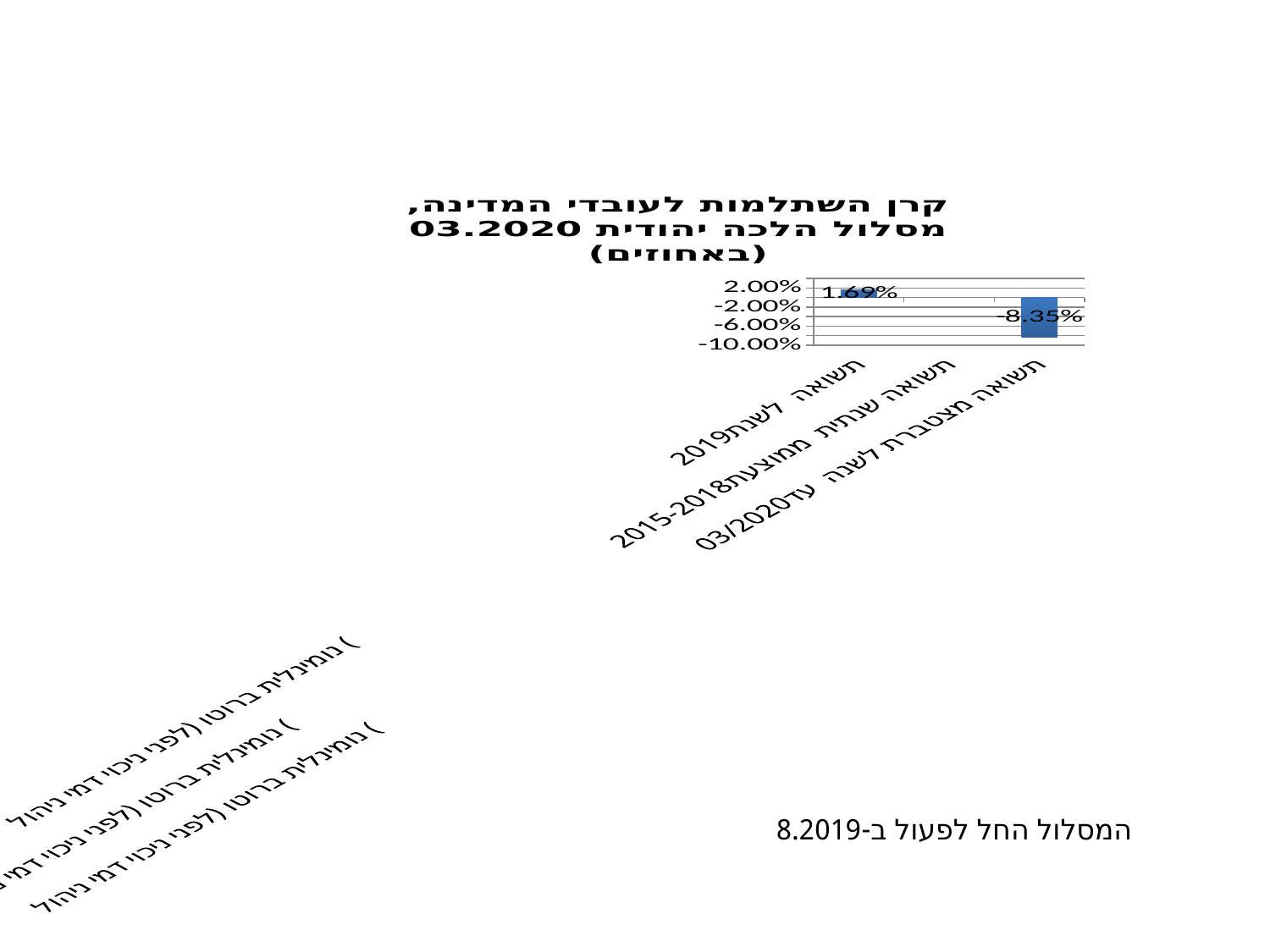
Is the value for תשואה לשנת 2019 greater or less than -2.00%? greater Which category has the lowest value in the chart? תשואה מצטברת לשנה עד 03/2020 What is the value shown for תשואה לשנת 2019? 1.69% How many categories are shown on the x axis of the chart? 3 What is the title of the chart? קרן השתלמות לעובדי המדינה, מסלול הלכה יהודית 03.2020 (באחוזים) What is the difference between the value for תשואה לשנת 2019 and the value for תשואה מצטברת לשנה עד 03/2020? 10.04 percentage points What is the lowest value shown on the chart's vertical axis? -10.00% Which is larger: the value for תשואה לשנת 2019 or the value for תשואה מצטברת לשנה עד 03/2020? תשואה לשנת 2019 Is the value for תשואה מצטברת לשנה עד 03/2020 greater or less than -6.00%? less What is the value shown for תשואה מצטברת לשנה עד 03/2020? -8.35% What kind of chart is shown on the slide? bar chart Which category has the highest value in the chart? תשואה לשנת 2019